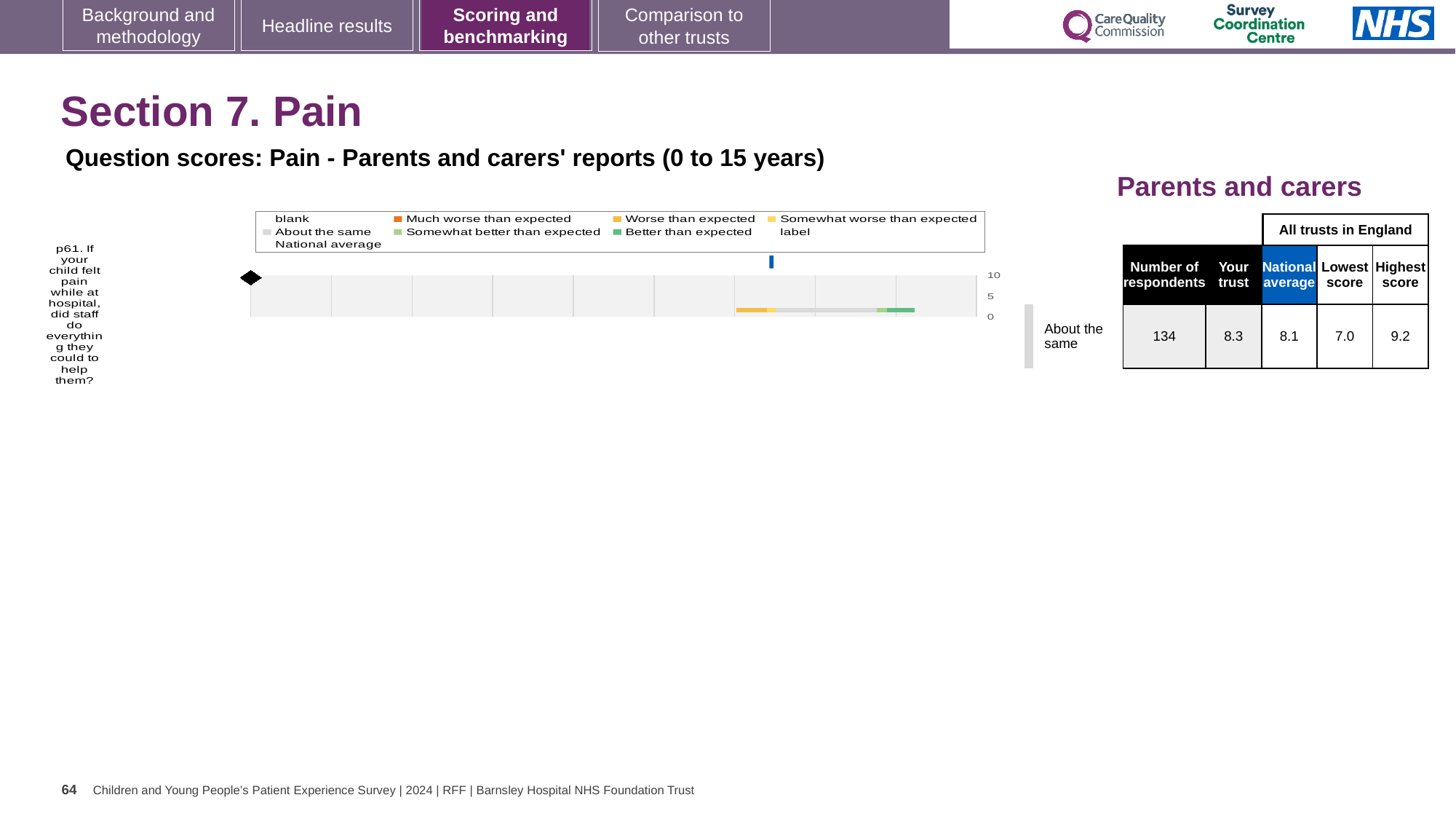
Using the table beside the chart, what is the difference between the highest score (9.2) and the lowest score (7.0) for p61? 2.2 According to the table beside the chart, what is the lowest score among all trusts in England for p61? 7.0 What is the highest value shown on the chart's axis? 10 According to the table beside the chart, how many respondents answered p61? 134 Is the national average marker on the chart positioned at a value greater or less than 5? greater What kind of chart is shown on the slide? bar chart Which legend entry is shown in orange? Much worse than expected What is the question number of the item plotted in the chart? p61 How many survey questions (categories) are plotted in the chart? 1 According to the table beside the chart, what is the highest score among all trusts in England for p61? 9.2 According to the table beside the chart, what is the 'Your trust' score for p61? 8.3 According to the table beside the chart, what is the national average score for p61? 8.1